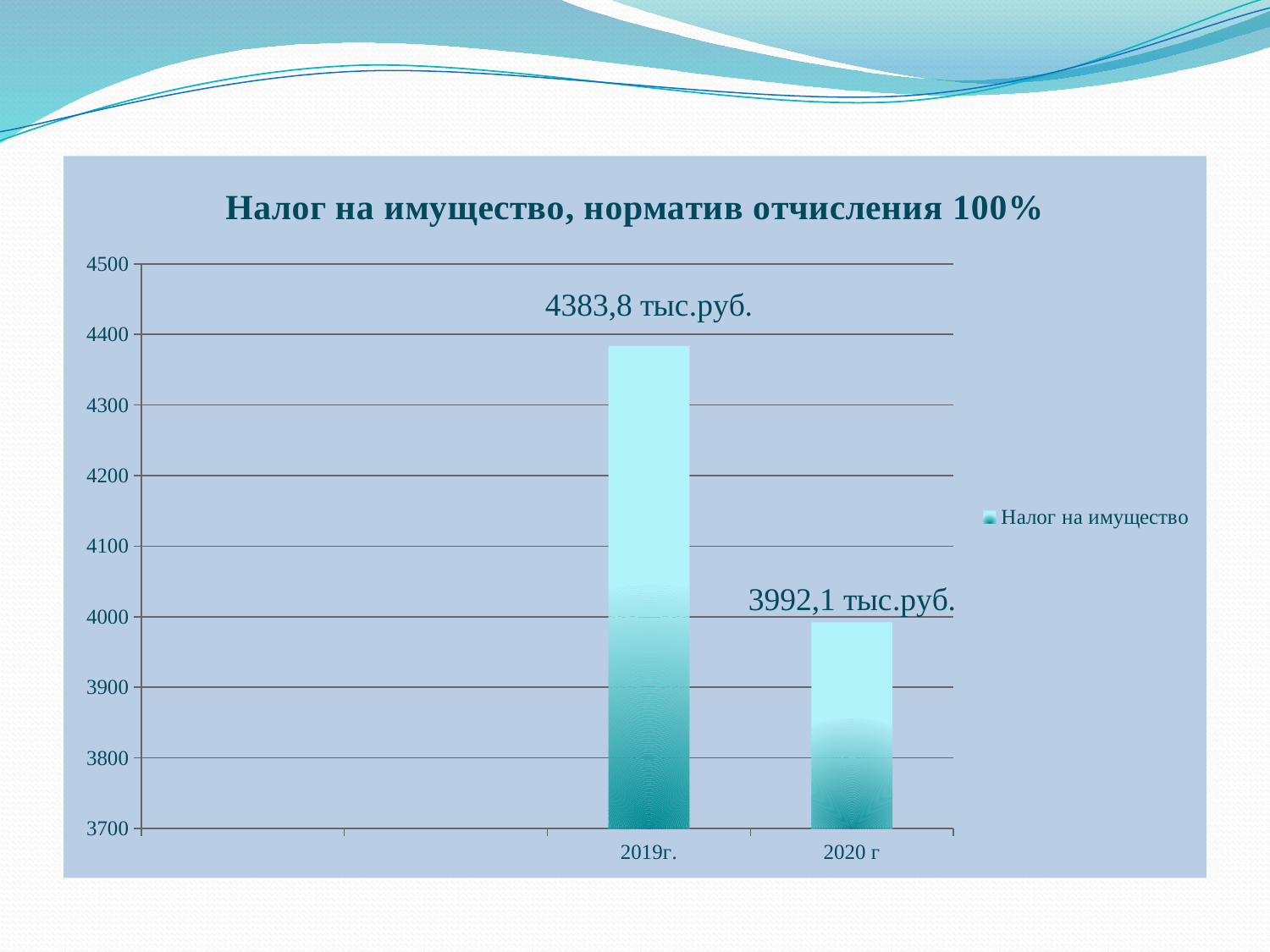
Which year has the lowest value? 2020 г What kind of chart is this? bar chart Which year has the highest value? 2019г. Is the value for 2019г. greater or less than 4300? greater Do the values rise or fall from 2019г. to 2020 г? fall What is the difference between the values for 2019г. and 2020 г? 391,7 тыс.руб. What is the value for 2020 г? 3992,1 тыс.руб. How many series does the legend list? 1 Is the value for 2020 г greater or less than 4000? less How many categories are shown on the x axis? 2 Which is larger, the value for 2019г. or the value for 2020 г? 2019г. What is the value for 2019г.? 4383,8 тыс.руб.